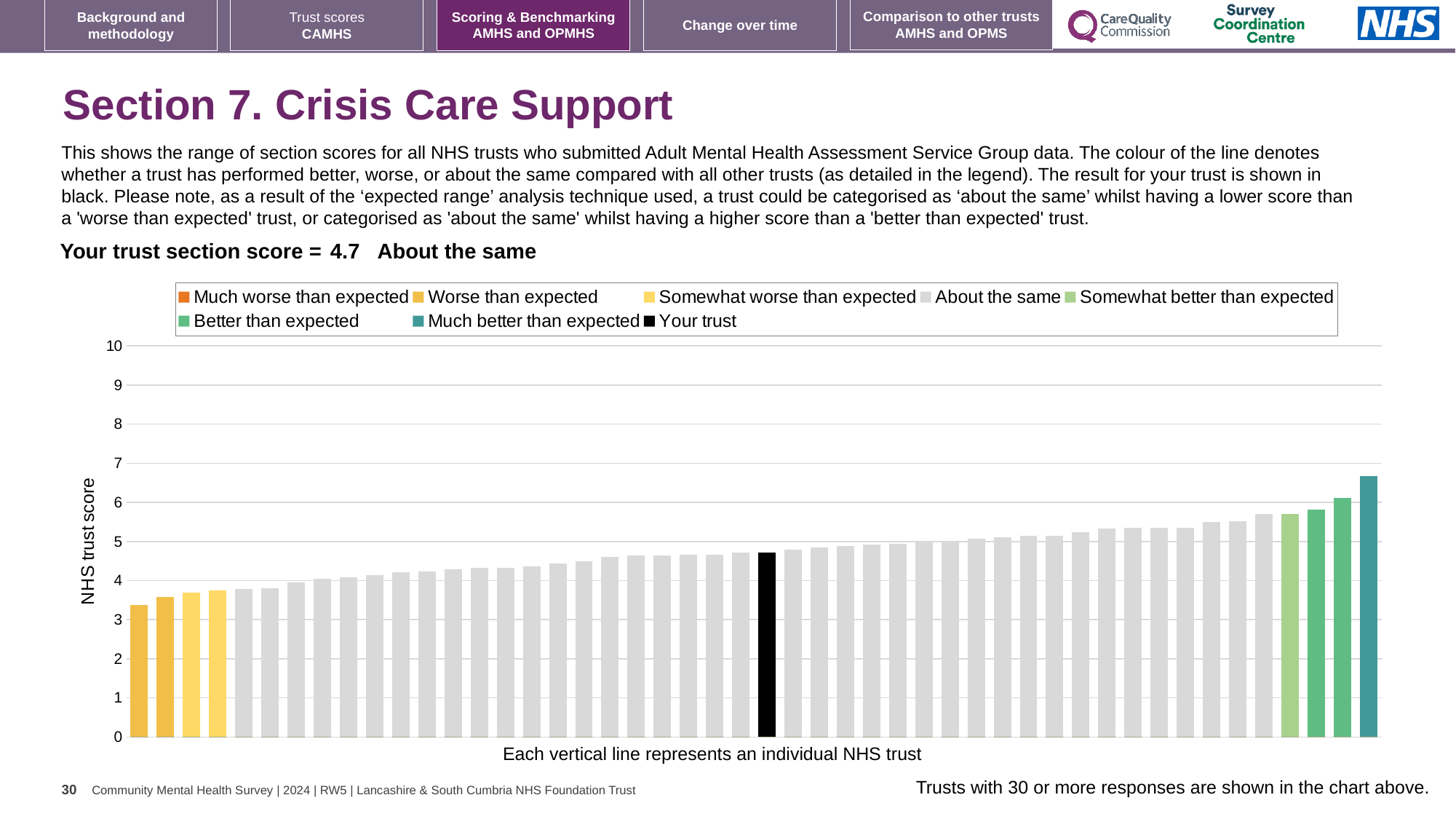
What kind of chart is shown on the slide? bar chart Do the bar values rise or fall from left to right along the x axis? rise Which legend category does the tallest bar belong to? Much better than expected What is the label on the vertical axis of the chart? NHS trust score Is the value for your trust (the black bar) greater or less than 5? less Which legend category does the shortest bar belong to? Worse than expected How is your trust's section score categorised compared with other trusts? About the same How many entries does the chart legend list? 8 What is the section score for your trust? 4.7 Is the value of the shortest bar greater or less than 4? less Is the value of the tallest bar greater or less than 6? greater Which is larger: the tallest bar or the black bar for your trust? the tallest bar